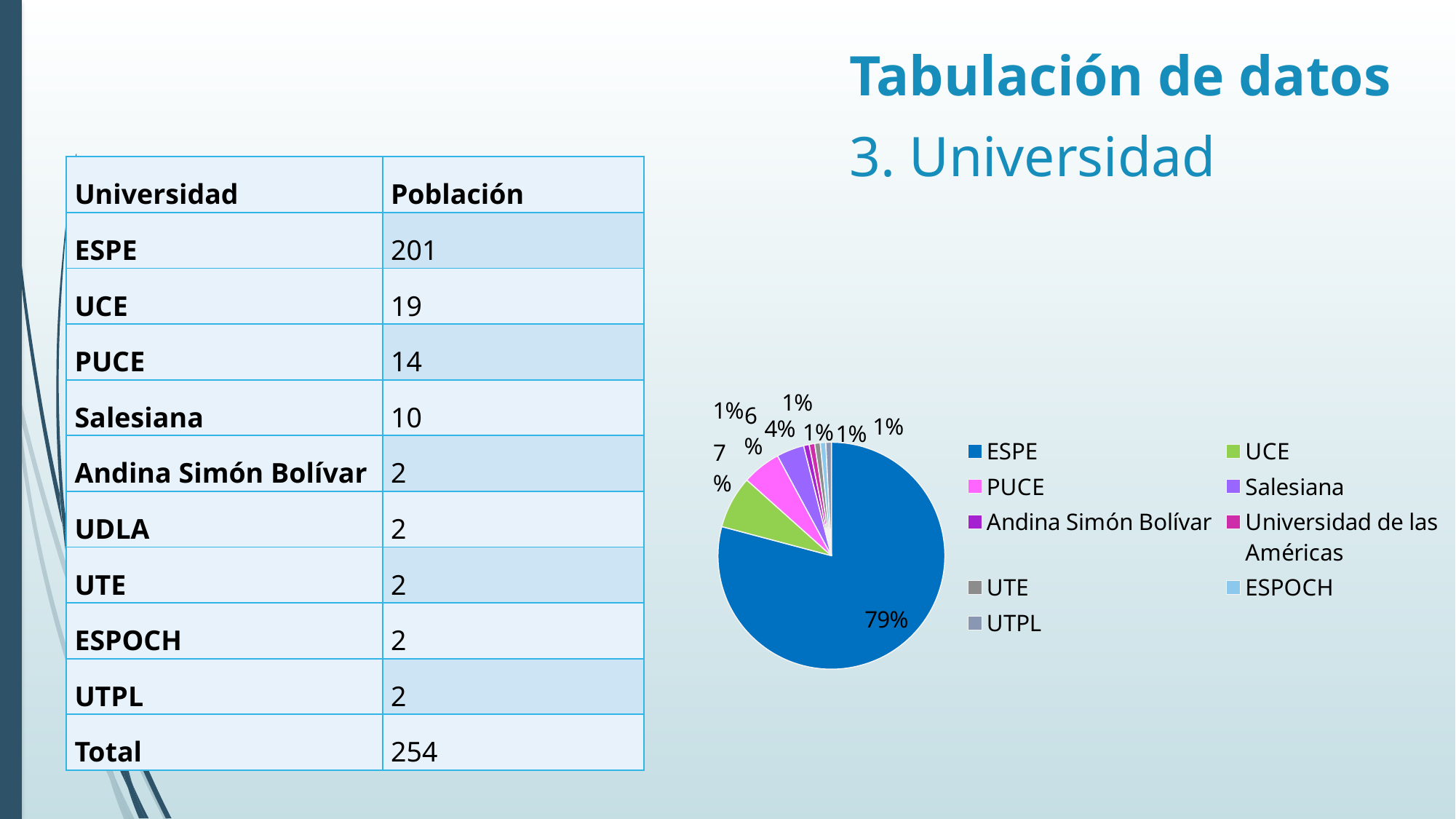
Which legend entry in the pie chart is listed directly below Salesiana in the right-hand column? Universidad de las Américas What share of the pie chart does PUCE have? 6% What colour is the ESPE slice in the pie chart? blue Which has the larger slice in the pie chart, UCE or PUCE? UCE What share of the pie chart does ESPE have? 79% By how many percentage points does ESPE's share exceed UCE's share in the pie chart? 72% How many slices in the pie chart are labelled 1%? 5 How many entries does the legend of the pie chart list? 9 What kind of chart is shown on the slide? pie chart Which university has the largest slice in the pie chart? ESPE What share of the pie chart does Salesiana have? 4% What share of the pie chart does UCE have? 7%